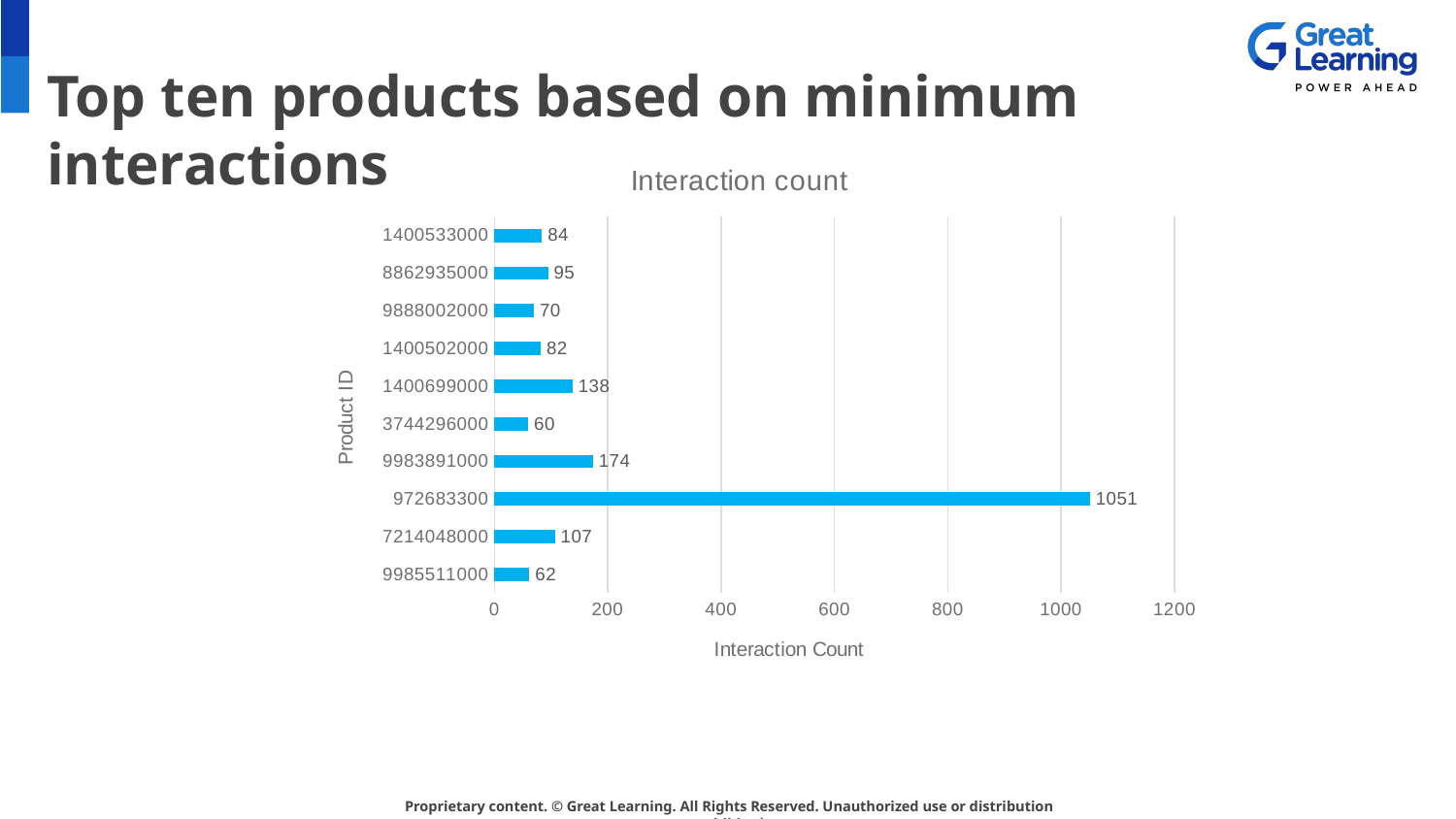
What is the difference in interaction count between product 972683300 and product 9983891000? 877 What is the interaction count for product ID 1400699000? 138 What is the difference in interaction count between product 8862935000 and product 9888002000? 25 What is the title of the chart? Interaction count What type of chart is shown on the slide? Bar chart Is the interaction count for product 972683300 greater or less than 1000? greater What is the interaction count for product ID 9985511000? 62 How many product IDs are shown in the chart? 10 What is the interaction count for product ID 972683300? 1051 Which product ID has the lowest interaction count? 3744296000 Which has a higher interaction count, product 7214048000 or product 1400502000? 7214048000 Which product ID has the highest interaction count? 972683300